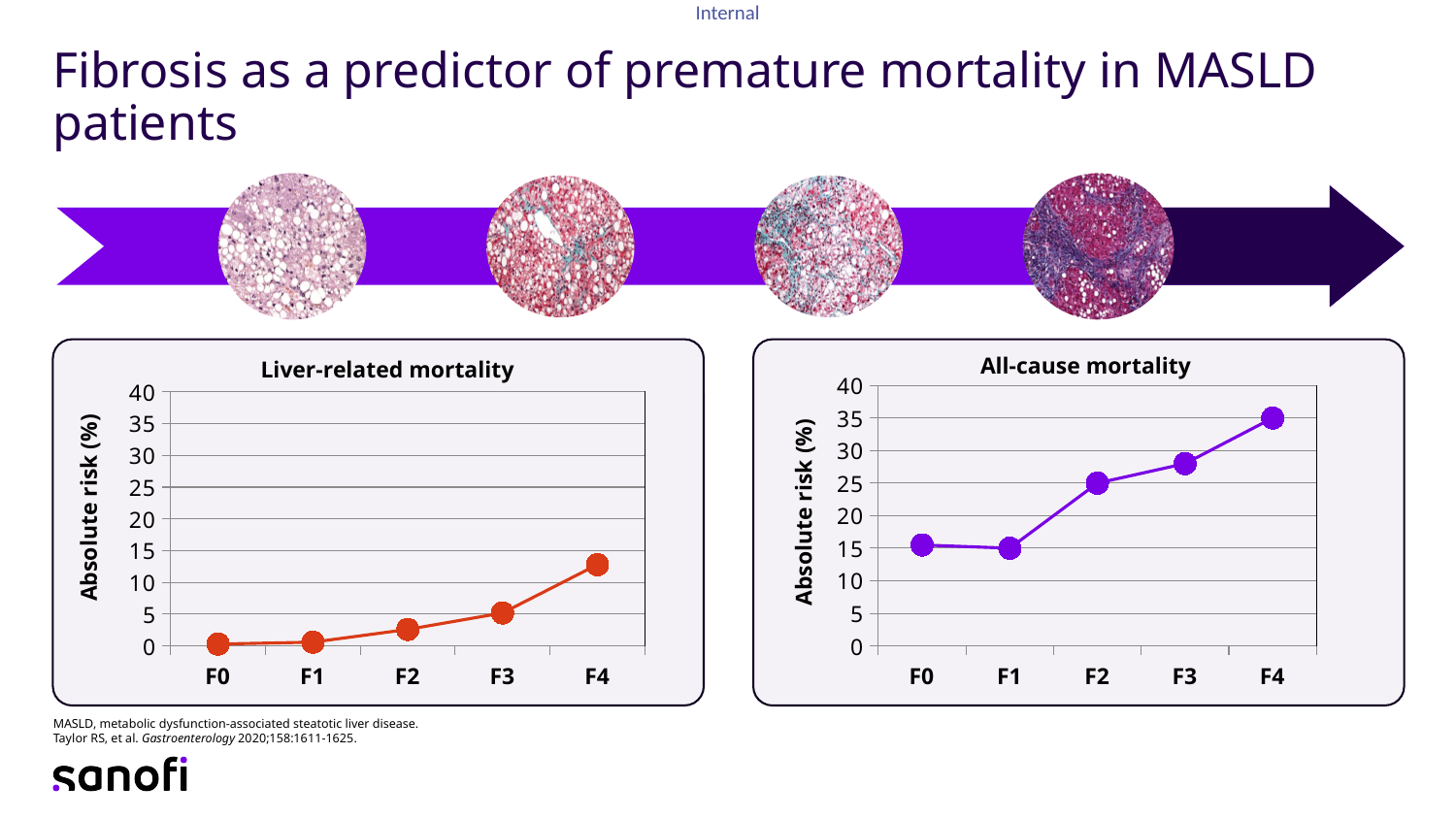
What is the y-axis label on the 'All-cause mortality' chart? Absolute risk (%) In the 'All-cause mortality' chart, is the value for F4 greater or less than 30? greater In the 'Liver-related mortality' chart, is the value for F4 greater or less than 10? greater In the 'Liver-related mortality' chart, do the values rise or fall from F0 to F4? rise In the 'Liver-related mortality' chart, is the value for F2 greater or less than 5? less In the 'Liver-related mortality' chart, which fibrosis stage has the lowest absolute risk? F0 In the 'All-cause mortality' chart, which has the larger absolute risk, F2 or F4? F4 In the 'Liver-related mortality' chart, which fibrosis stage has the highest absolute risk? F4 In the 'All-cause mortality' chart, which fibrosis stage has the highest absolute risk? F4 How many fibrosis stages are plotted on the x axis of the 'All-cause mortality' chart? 5 What kind of chart is the 'Liver-related mortality' chart? line chart